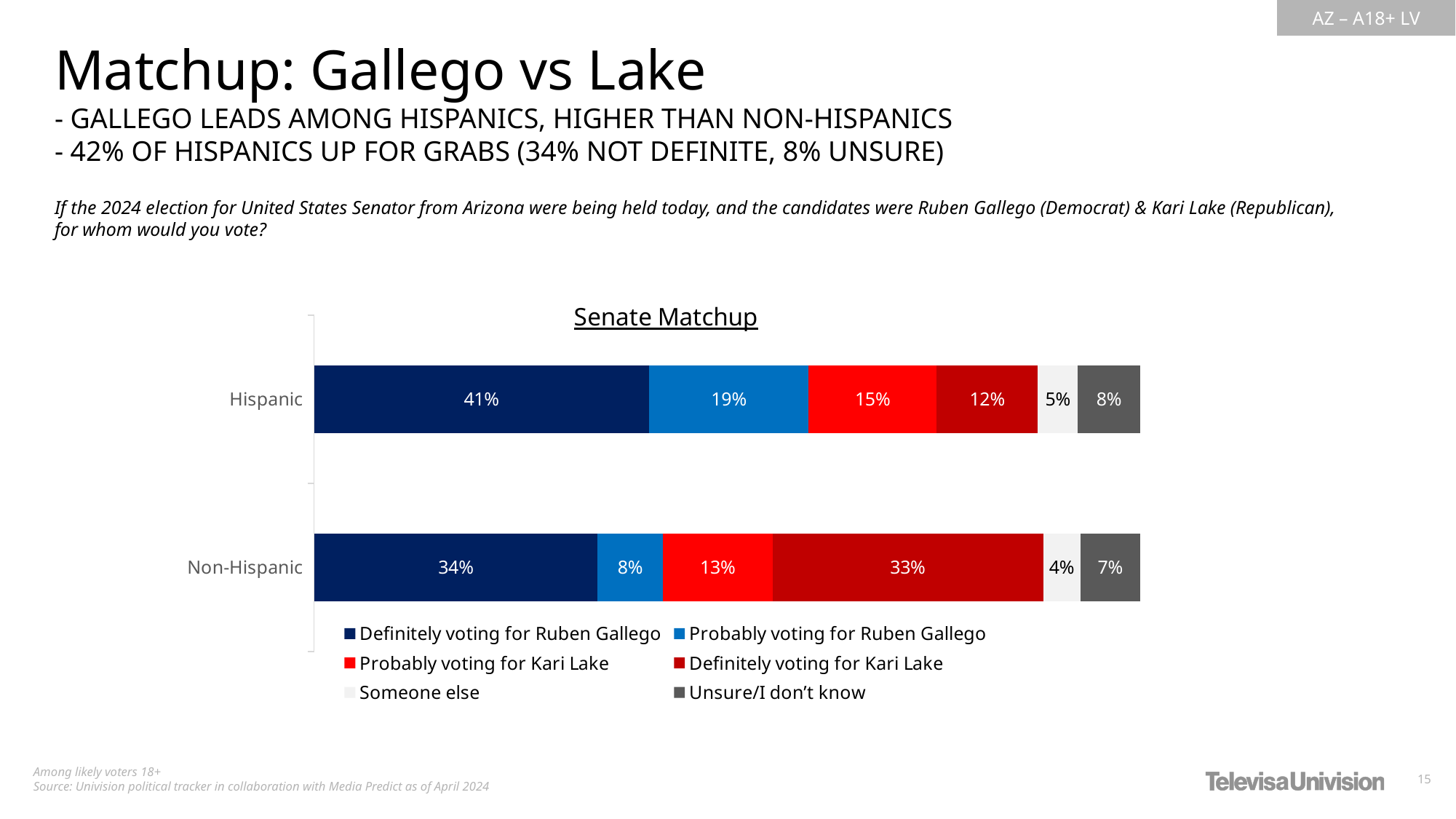
What percentage of Hispanic respondents are probably voting for Ruben Gallego? 19% How many groups (categories) are shown on the chart? 2 Which response category has the smallest share among Non-Hispanic respondents? Someone else Which response category has the largest share among Hispanic respondents? Definitely voting for Ruben Gallego What is the difference between the Hispanic and Non-Hispanic shares probably voting for Ruben Gallego? 11 percentage points Which group has the higher share definitely voting for Kari Lake, Hispanic or Non-Hispanic? Non-Hispanic What percentage of Non-Hispanic respondents answered Unsure/I don't know? 7% What is the title of the chart? Senate Matchup What kind of chart is the Senate Matchup chart? Stacked bar chart What percentage of Hispanic likely voters are definitely voting for Ruben Gallego? 41% What percentage of Non-Hispanic likely voters are definitely voting for Kari Lake? 33% How many series does the legend list? 6